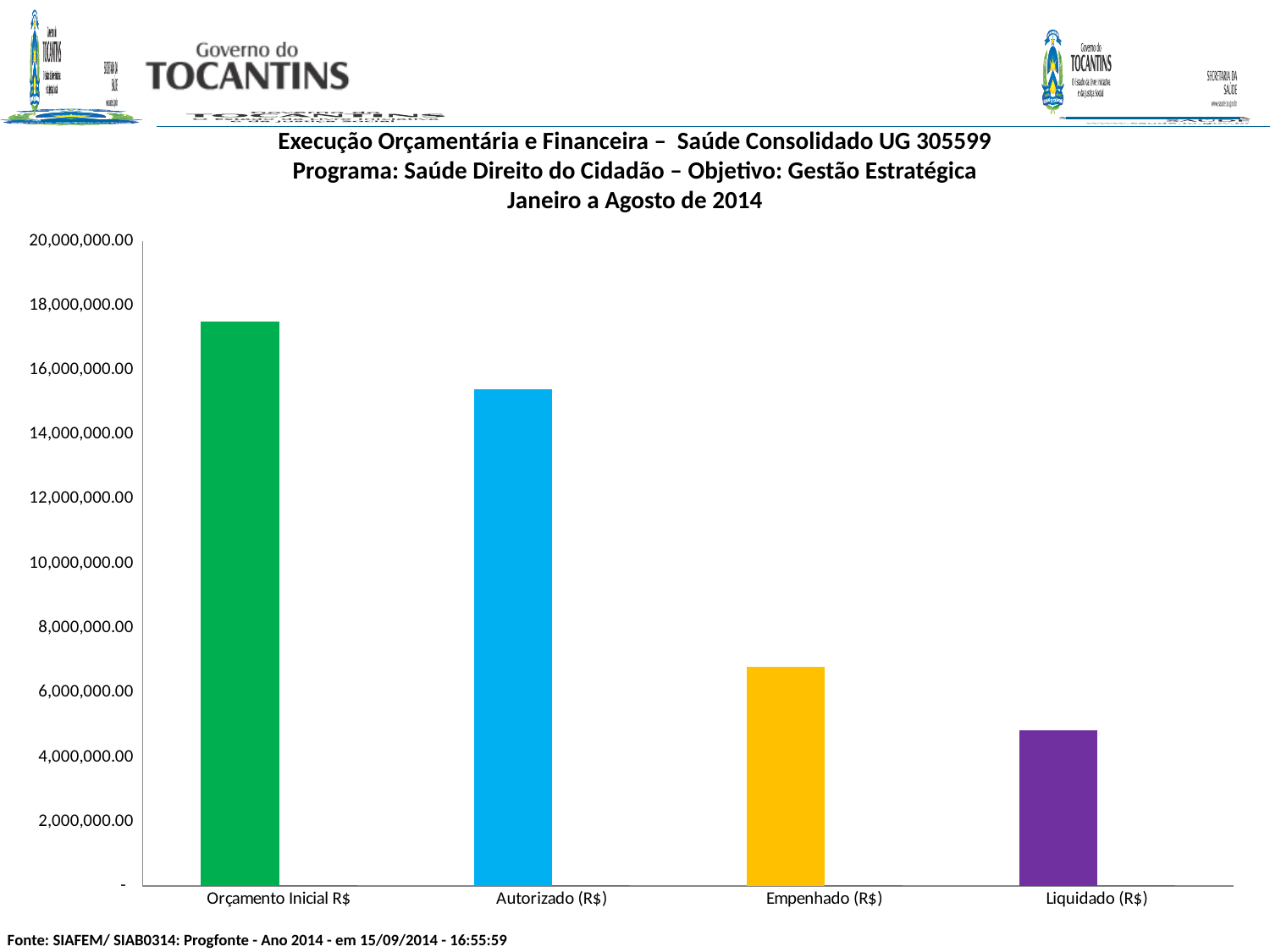
Is the value for Orçamento Inicial R$ greater or less than 16,000,000.00? greater Which category has the lowest value? Liquidado (R$) What kind of chart is shown on the slide? bar chart How many categories are plotted on the chart? 4 Which category has the highest value? Orçamento Inicial R$ Is the value for Autorizado (R$) greater or less than 16,000,000.00? less Is the value for Liquidado (R$) greater or less than 6,000,000.00? less Do the values rise or fall from left to right across the categories? fall What period does the chart title say the data covers? Janeiro a Agosto de 2014 Which is larger, the value for Empenhado (R$) or the value for Liquidado (R$)? Empenhado (R$) Which is larger, the value for Autorizado (R$) or the value for Empenhado (R$)? Autorizado (R$)